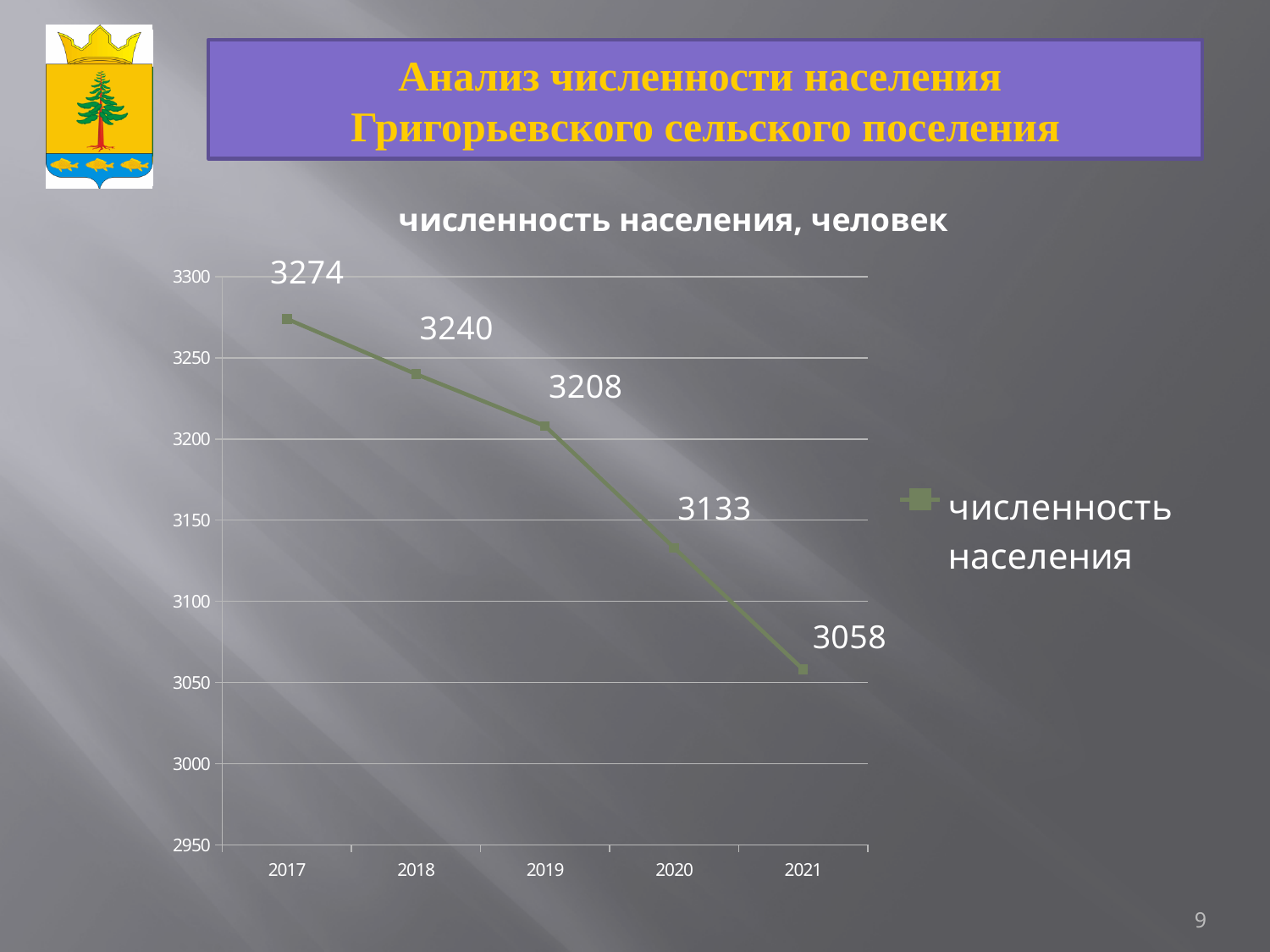
What is the difference between the population in 2019 and in 2020? 75 Which is larger, the population in 2018 or in 2020? 2018 Which year has the lowest population? 2021 Which year has the highest population? 2017 How many years are plotted on the chart? 5 Is the value for 2020 greater or less than 3150? less What is the population value for 2021? 3058 What kind of chart is shown on the slide? line chart What is the difference between the population in 2017 and in 2021? 216 Does the population rise or fall from 2017 to 2021? fall What is the population value for 2017? 3274 What is the population value for 2019? 3208